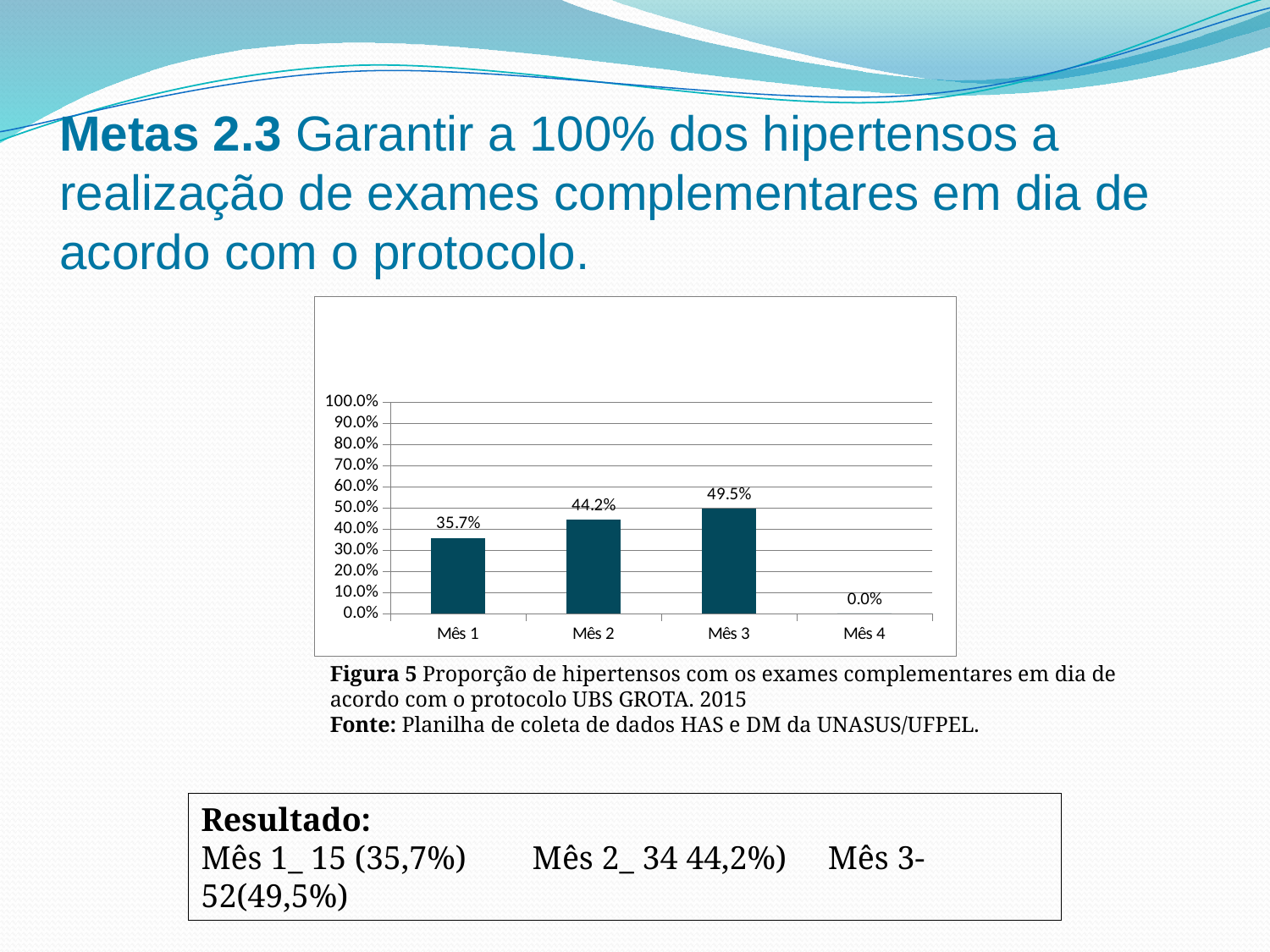
What kind of chart is shown on the slide? bar chart What is the value for Mês 2? 44.2% How many months are shown on the x axis? 4 Which month has the lowest value? Mês 4 What is the value for Mês 3? 49.5% Do the values rise or fall from Mês 1 to Mês 3? rise Is the value for Mês 3 greater or less than 50.0%? less What is the value for Mês 4? 0.0% Which is larger, the value for Mês 2 or the value for Mês 1? Mês 2 What is the difference between the values for Mês 3 and Mês 1? 13.8% What is the value for Mês 1? 35.7% Which month has the highest value? Mês 3